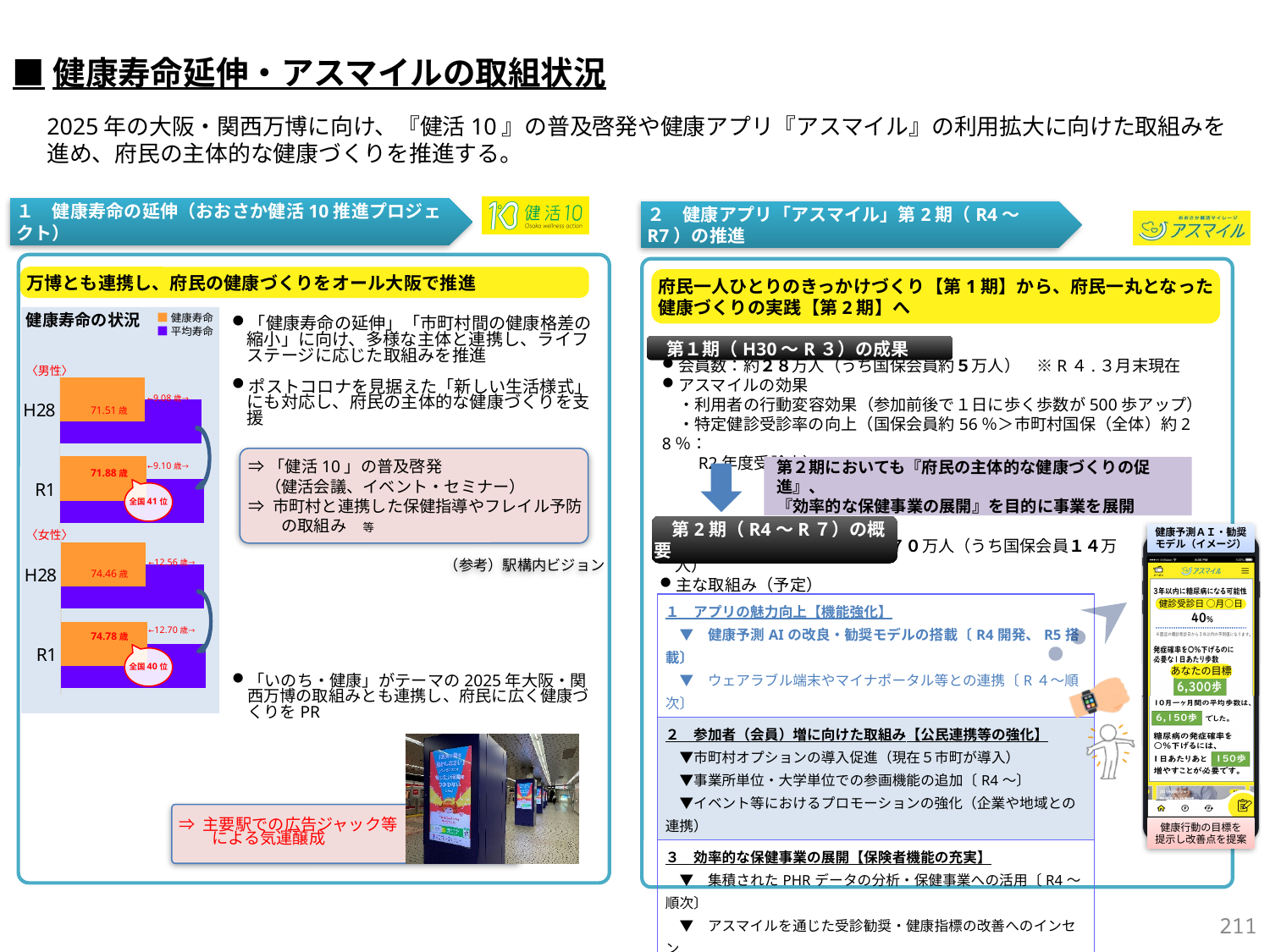
In the 健康寿命の状況 chart, what is the labelled gap between 健康寿命 and 平均寿命 for 女性 in R1? 12.70歳 In the 健康寿命の状況 chart, by how much did the 健康寿命 for 男性 increase from H28 to R1? 0.37歳 What kind of chart is the 健康寿命の状況 chart? bar chart In the 健康寿命の状況 chart, what is the 健康寿命 value for 女性 in H28? 74.46歳 In the 健康寿命の状況 chart, which is larger in R1: the 健康寿命 for 男性 or for 女性? 女性 How many series does the legend of the 健康寿命の状況 chart list? 2 In the 健康寿命の状況 chart, which bar shows the highest 健康寿命 value? 女性 R1 In the 健康寿命の状況 chart, what is the 健康寿命 value for 女性 in R1? 74.78歳 In the 健康寿命の状況 chart, what is the 健康寿命 value for 男性 in H28? 71.51歳 What are the two series named in the legend of the 健康寿命の状況 chart? 健康寿命, 平均寿命 In the 健康寿命の状況 chart, which bar shows the lowest 健康寿命 value? 男性 H28 In the 健康寿命の状況 chart, what is the 健康寿命 value for 男性 in R1? 71.88歳